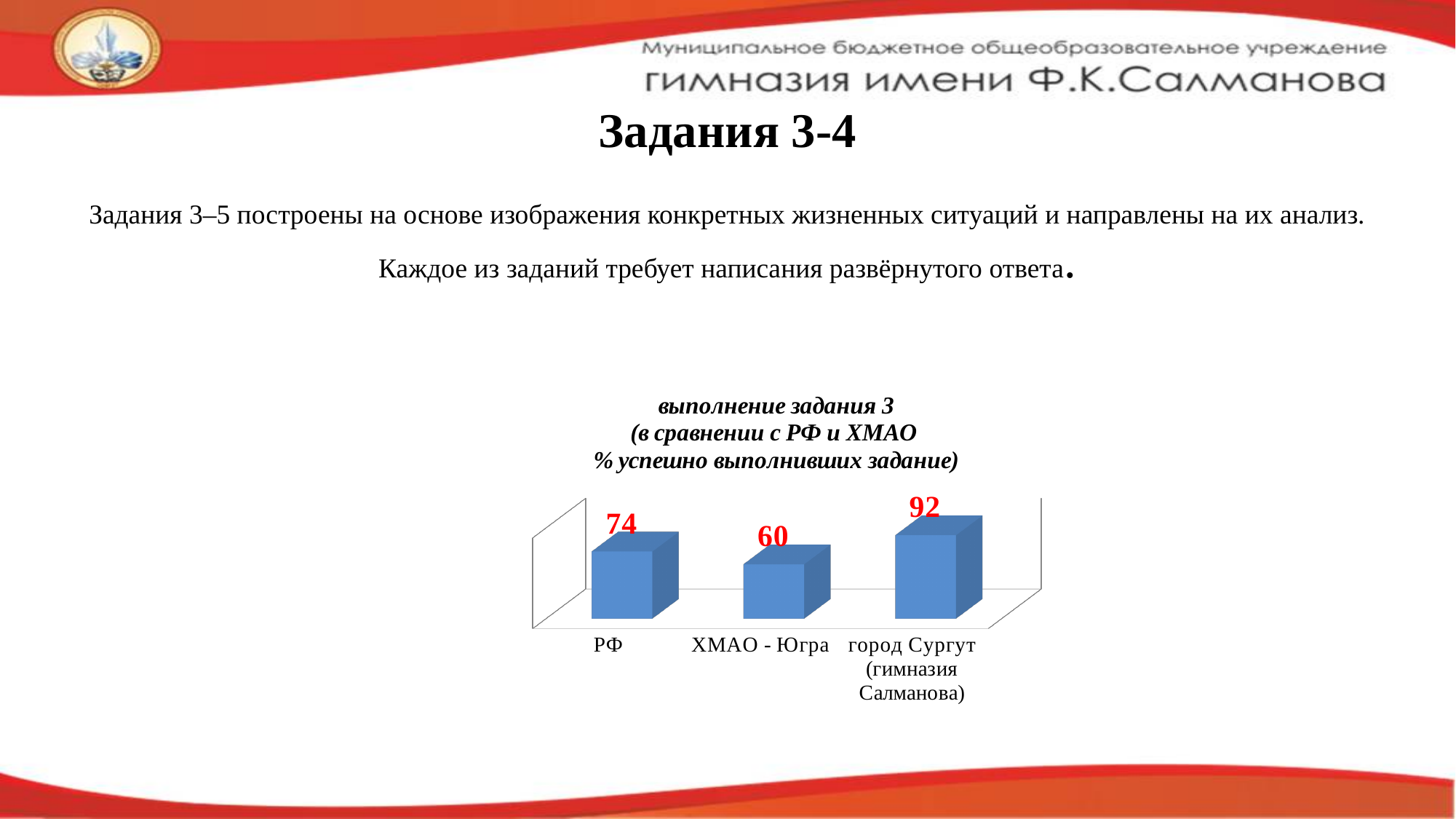
Which is larger, the value for РФ or the value for ХМАО - Югра? РФ Which category has the highest value? город Сургут (гимназия Салманова) What is the title of the chart? выполнение задания 3 (в сравнении с РФ и ХМАО % успешно выполнивших задание) What is the value for РФ? 74 What is the difference between the values for РФ and ХМАО - Югра? 14 What colour are the bars in the chart? blue What is the difference between the values for город Сургут (гимназия Салманова) and РФ? 18 What is the value for ХМАО - Югра? 60 Which category has the lowest value? ХМАО - Югра What kind of chart is shown on the slide? bar chart How many categories are shown in the chart? 3 What is the value for город Сургут (гимназия Салманова)? 92